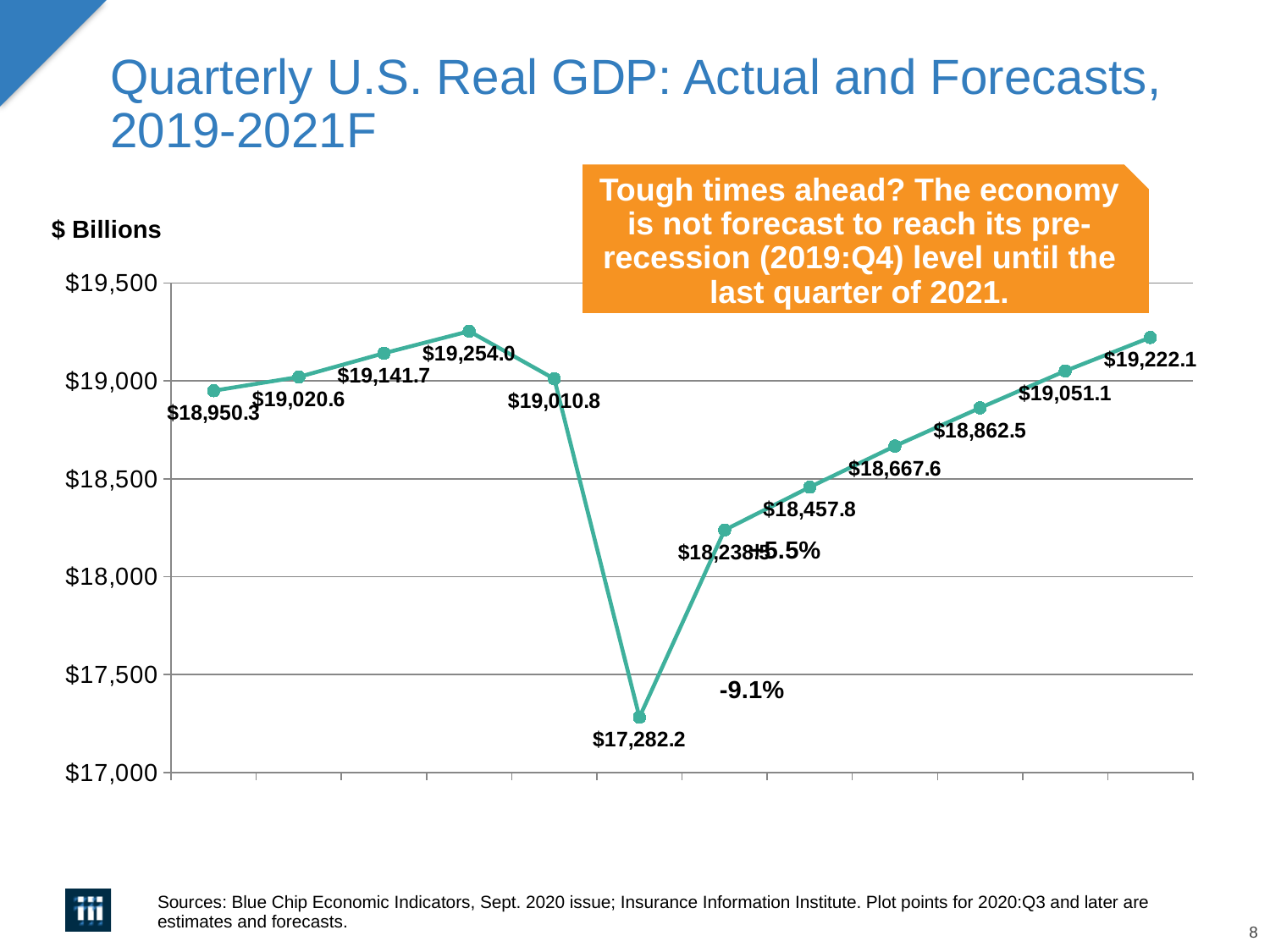
What unit is shown above the y axis of the chart? $ Billions What is the highest value plotted on the chart? $19,254.0 By how much does the last point ($19,222.1) exceed the first point ($18,950.3)? $271.8 What is the value of the first (leftmost) point on the line? $18,950.3 How many data points are plotted on the line? 12 After the lowest point, do the values rise or fall moving to the right along the x axis? rise Is the lowest point on the line greater or less than $17,500? less What kind of chart is shown on the slide? line chart What is the difference between the highest value ($19,254.0) and the lowest value ($17,282.2) on the chart? $1,971.8 What is the value of the last (rightmost) point on the line? $19,222.1 Which is larger: the peak value before the drop or the final value at the right end of the line? the peak value before the drop ($19,254.0) What is the lowest value plotted on the chart? $17,282.2